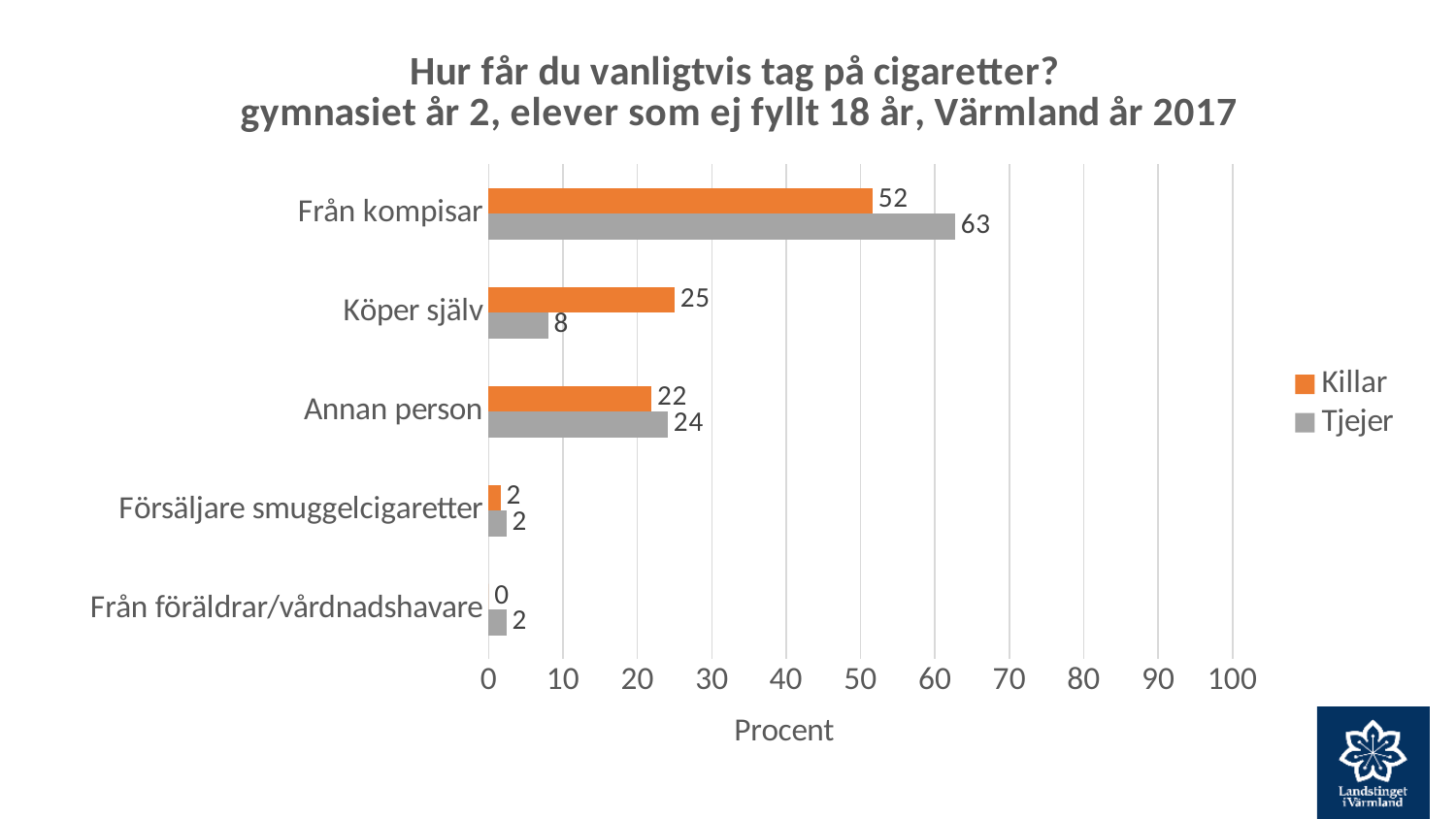
Which category has the lowest value for Killar? Från föräldrar/vårdnadshavare What is the difference between the Tjejer and Killar values for Från kompisar? 11 What kind of chart is shown on the slide? Bar chart How many series does the legend list? 2 How many categories are shown on the y axis? 5 Which is larger for Annan person, the Killar value or the Tjejer value? Tjejer What is the value for Tjejer for Köper själv? 8 What is the value for Killar for Från föräldrar/vårdnadshavare? 0 What is the difference between the Killar and Tjejer values for Köper själv? 17 What is the value for Tjejer for Från kompisar? 63 What is the value for Killar for Från kompisar? 52 Which category has the highest value for Tjejer? Från kompisar